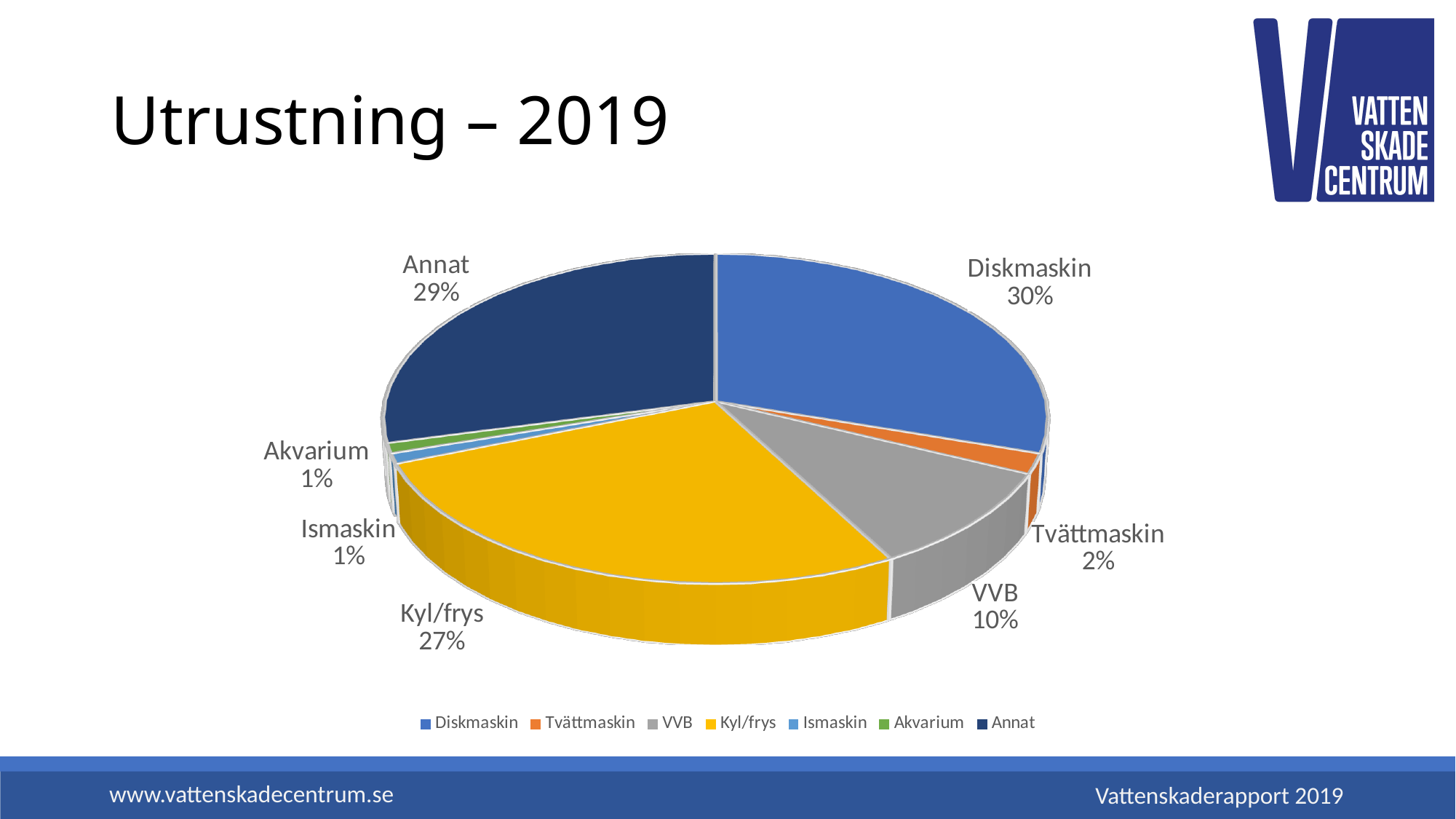
What is the difference in percentage points between Annat and Kyl/frys? 2 What share of the pie does VVB have? 10% Which is larger, the share for VVB or the share for Tvättmaskin? VVB What share of the pie does Tvättmaskin have? 2% What share of the pie does Kyl/frys have? 27% Which colour represents Kyl/frys in the legend? yellow What is the difference in percentage points between Diskmaskin and VVB? 20 How many categories does the pie chart show? 7 Which category has the largest share of the pie? Diskmaskin What kind of chart is shown on the slide? pie chart What is the title of the slide containing the pie chart? Utrustning – 2019